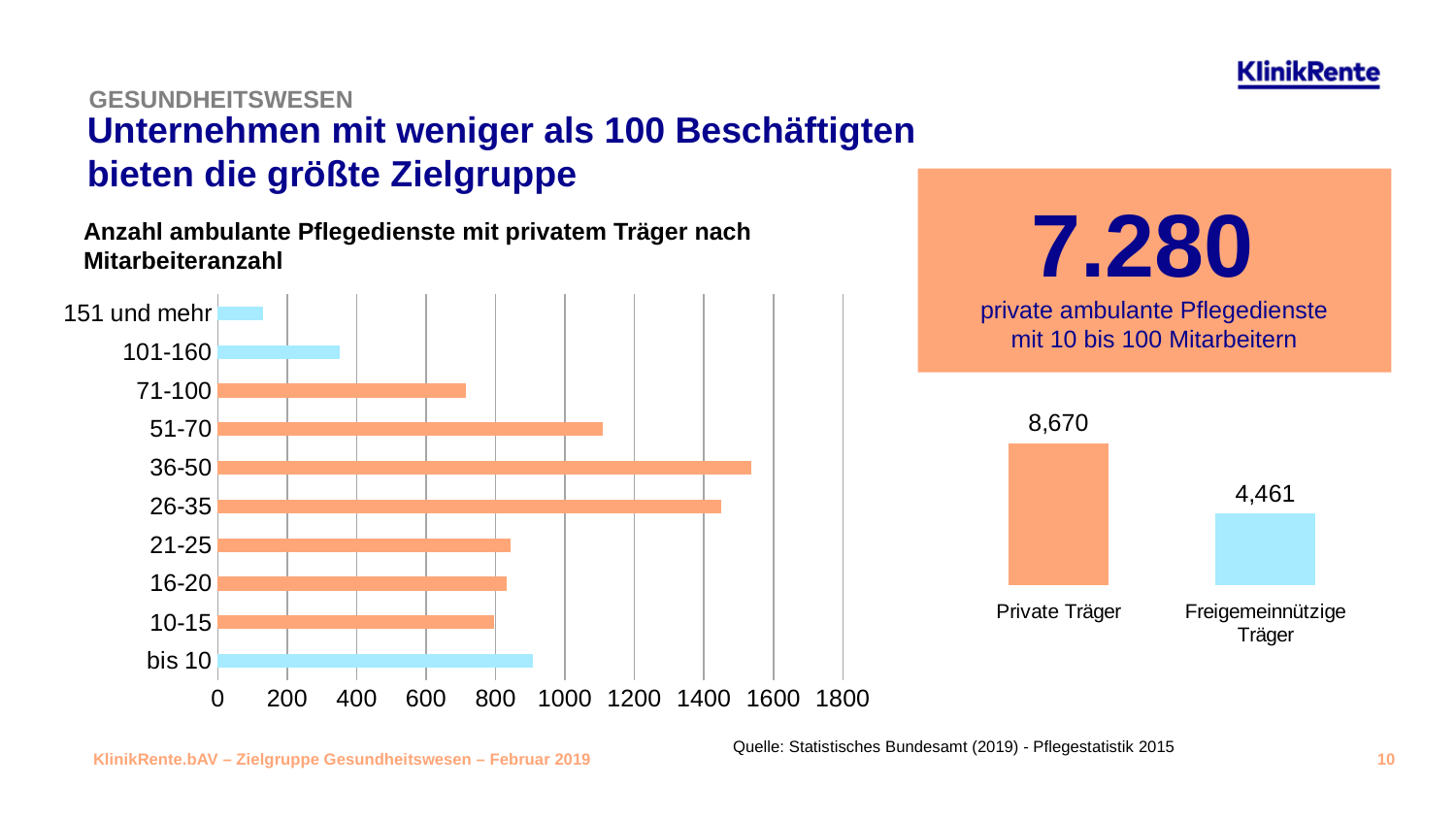
In the right chart comparing Private Träger and Freigemeinnützige Träger, what is the difference between the two values? 4,209 In the left chart 'Anzahl ambulante Pflegedienste mit privatem Träger nach Mitarbeiteranzahl', is the value for 36-50 greater or less than 1400? greater In the left chart 'Anzahl ambulante Pflegedienste mit privatem Träger nach Mitarbeiteranzahl', how many employee-size categories are shown? 10 In the left chart 'Anzahl ambulante Pflegedienste mit privatem Träger nach Mitarbeiteranzahl', is the value for 71-100 greater or less than 600? greater In the right chart comparing Private Träger and Freigemeinnützige Träger, which category has the higher value? Private Träger In the right chart comparing Private Träger and Freigemeinnützige Träger, what is the value for Freigemeinnützige Träger? 4,461 In the left chart 'Anzahl ambulante Pflegedienste mit privatem Träger nach Mitarbeiteranzahl', which category has the lowest value? 151 und mehr In the left chart 'Anzahl ambulante Pflegedienste mit privatem Träger nach Mitarbeiteranzahl', which category has the highest value? 36-50 In the left chart 'Anzahl ambulante Pflegedienste mit privatem Träger nach Mitarbeiteranzahl', is the value for 101-160 greater or less than 400? less In the left chart 'Anzahl ambulante Pflegedienste mit privatem Träger nach Mitarbeiteranzahl', which is larger, the value for 51-70 or the value for 21-25? 51-70 What kind of chart is the left chart titled 'Anzahl ambulante Pflegedienste mit privatem Träger nach Mitarbeiteranzahl'? bar chart In the right chart comparing Private Träger and Freigemeinnützige Träger, what is the value for Private Träger? 8,670